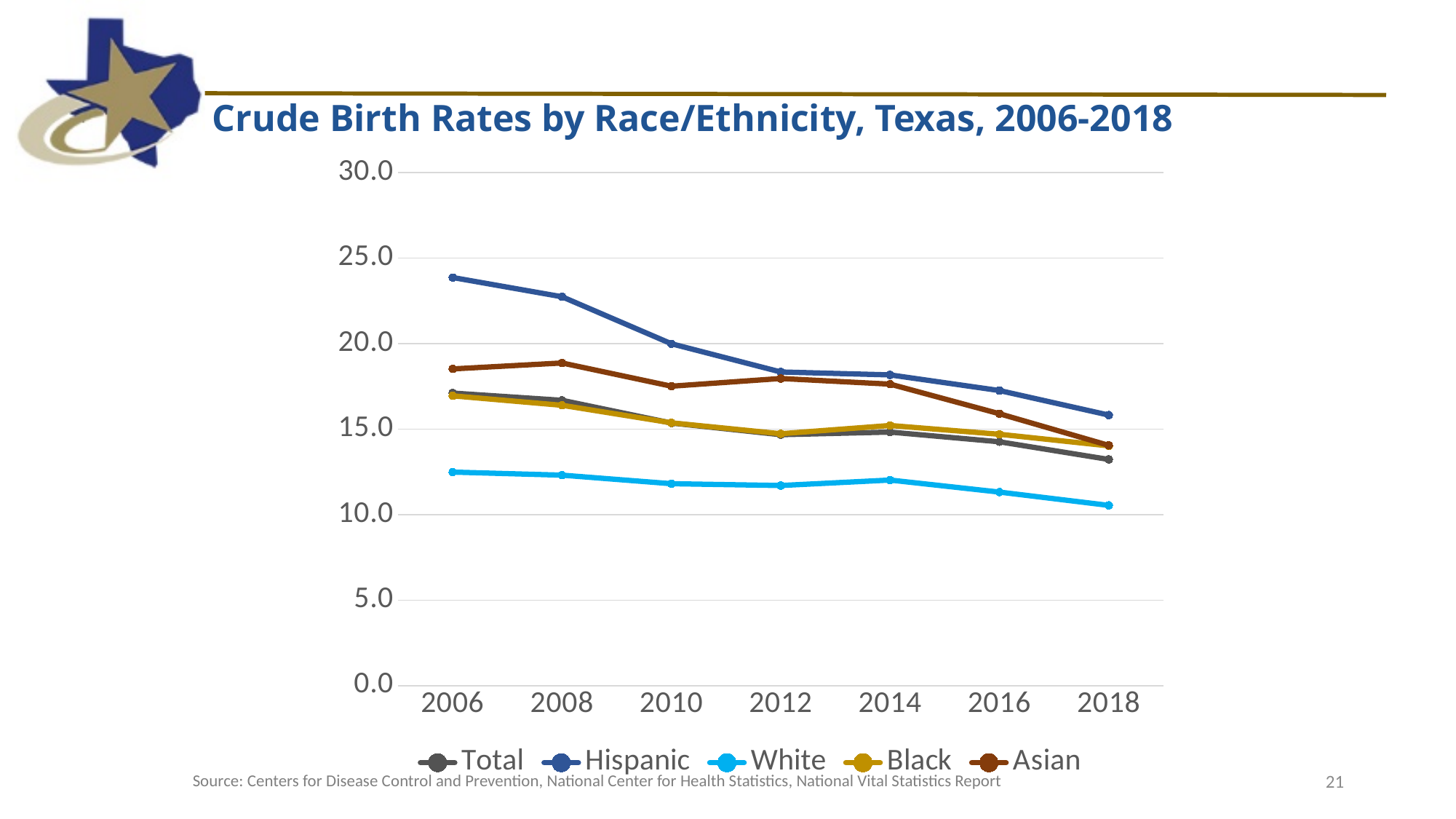
In 2010, which is larger: the Hispanic crude birth rate or the Asian crude birth rate? Hispanic How many years are labelled on the x axis? 7 Is the Asian crude birth rate in 2018 greater or less than 15.0? less Which race/ethnicity group has the lowest crude birth rate in 2018? White Is the Hispanic crude birth rate in 2006 greater or less than 20.0? greater What kind of chart is shown on the slide? Line chart What is the title of the chart? Crude Birth Rates by Race/Ethnicity, Texas, 2006-2018 How many series does the legend list? 5 Does the Hispanic crude birth rate rise or fall from 2006 to 2018? Fall Which race/ethnicity group has the highest crude birth rate in 2006? Hispanic Is the White crude birth rate in 2018 greater or less than 15.0? less In 2016, which is larger: the Asian crude birth rate or the Total crude birth rate? Asian